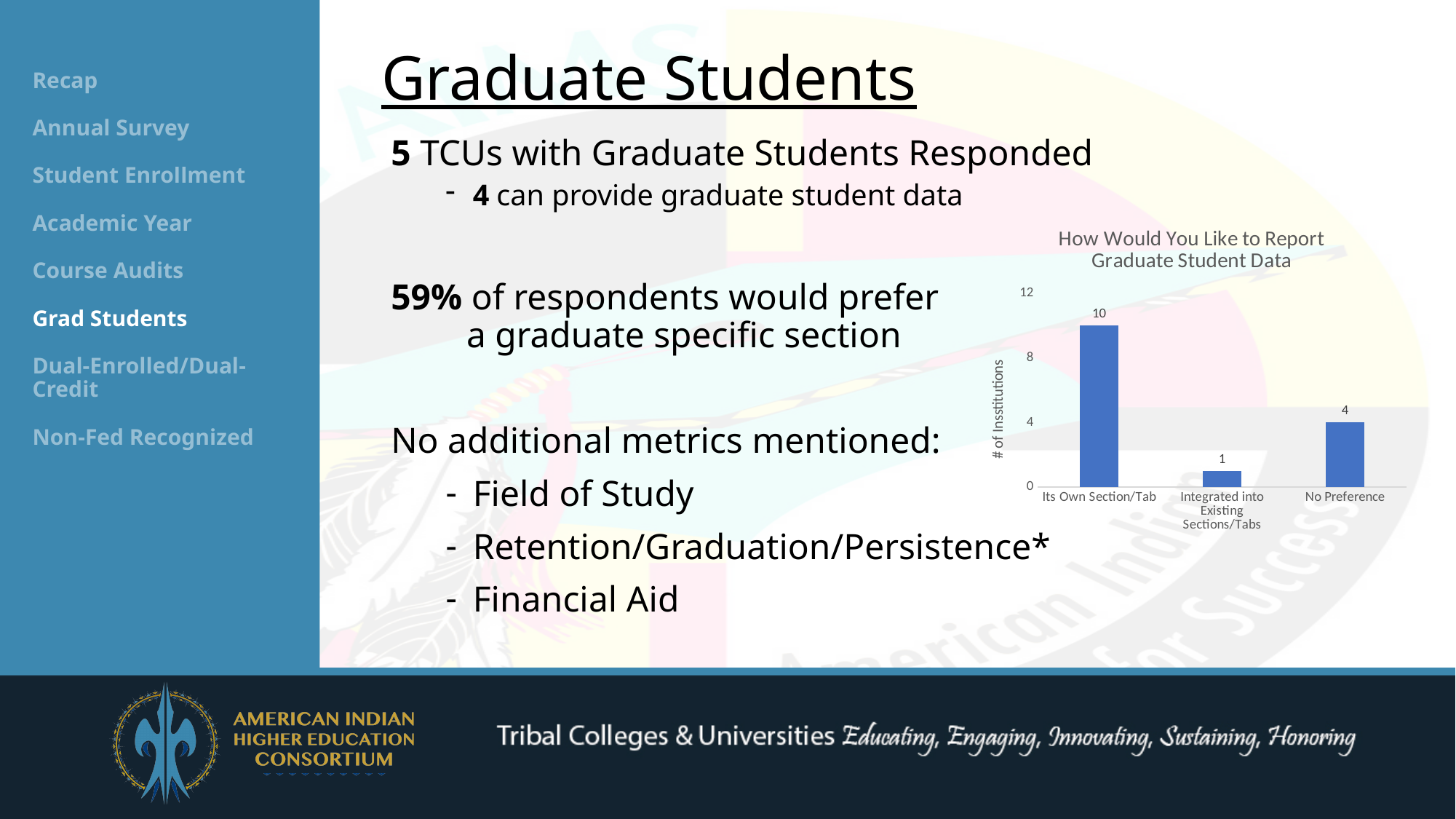
What is the value for Integrated into Existing Sections/Tabs? 1 What is the difference between the values for Its Own Section/Tab and No Preference? 6 Which is larger, the value for No Preference or the value for Integrated into Existing Sections/Tabs? No Preference What is the difference between the values for No Preference and Integrated into Existing Sections/Tabs? 3 What kind of chart is shown on the slide? bar chart What is the title of the chart? How Would You Like to Report Graduate Student Data What is the value for Its Own Section/Tab? 10 How many categories are shown on the chart? 3 Which category has the lowest number of institutions? Integrated into Existing Sections/Tabs What is the value for No Preference? 4 Which category has the highest number of institutions? Its Own Section/Tab Is the value for Its Own Section/Tab greater or less than 8? greater